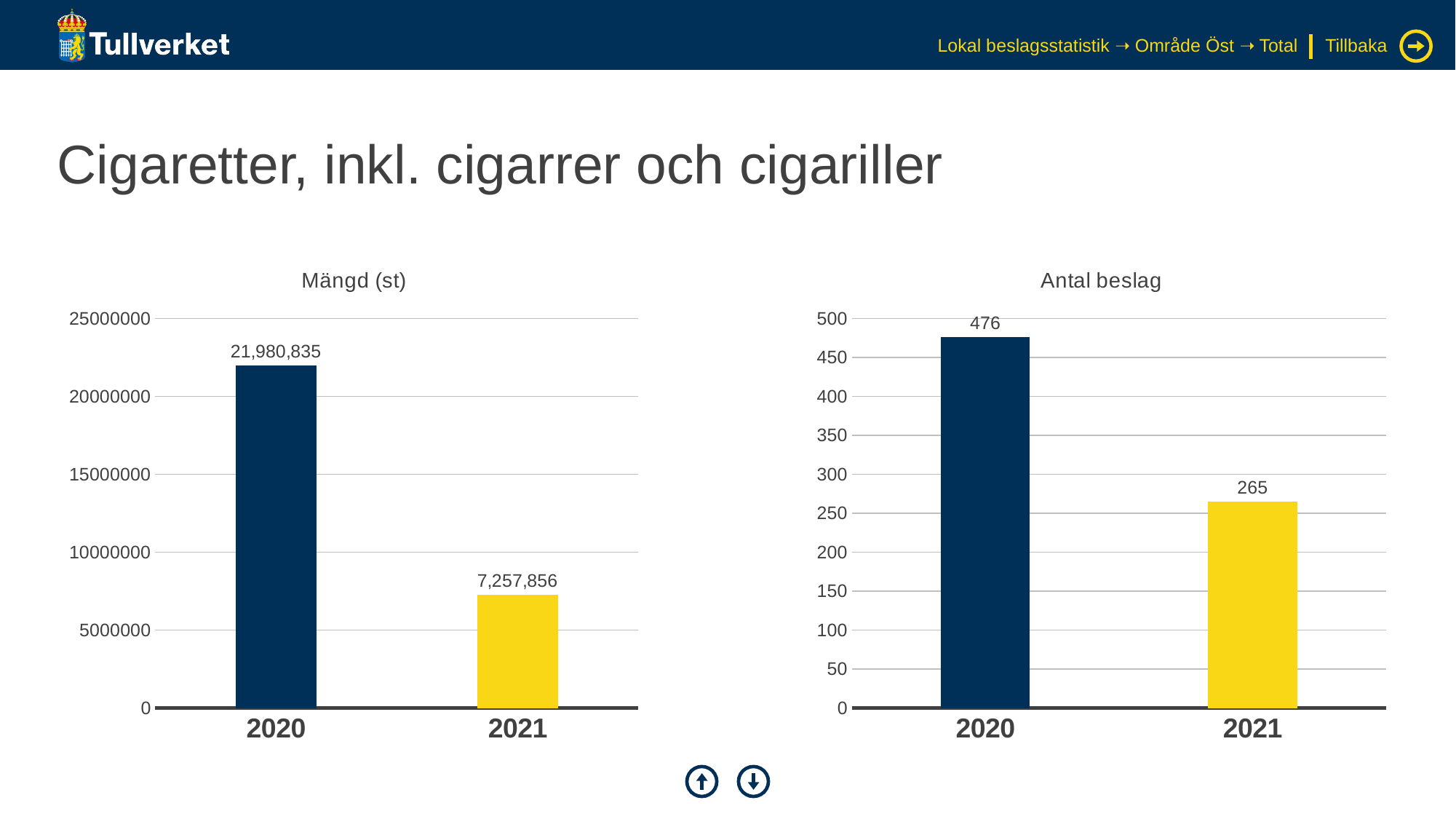
In the 'Antal beslag' chart, what is the value for 2020? 476 In the 'Mängd (st)' chart, which year has the lowest value? 2021 In the 'Mängd (st)' chart, what is the value for 2021? 7,257,856 In the 'Mängd (st)' chart, what is the value for 2020? 21,980,835 In the 'Mängd (st)' chart, do the values rise or fall from 2020 to 2021? fall In the 'Antal beslag' chart, what is the value for 2021? 265 In the 'Antal beslag' chart, what is the difference between the 2020 and 2021 values? 211 In the 'Mängd (st)' chart, is the value for 2021 greater or less than 10000000? less In the 'Mängd (st)' chart, what is the difference between the 2020 and 2021 values? 14,722,979 In the 'Antal beslag' chart, how many years are shown? 2 What kind of chart is the 'Antal beslag' chart? bar chart In the 'Antal beslag' chart, which year has the highest value? 2020